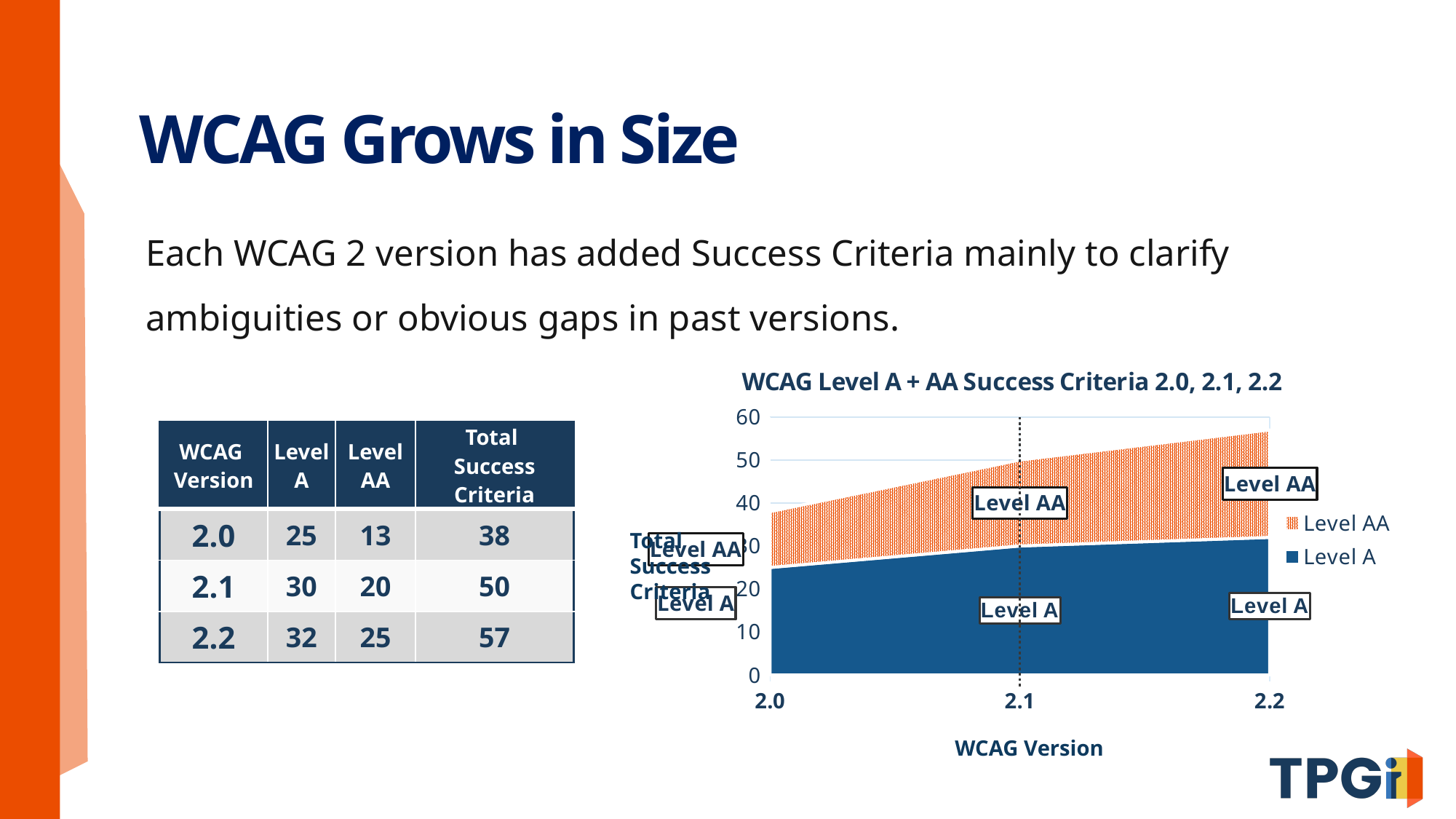
Which WCAG version has the highest total number of success criteria? 2.2 How many series does the chart legend list? 2 How many Level A success criteria does WCAG 2.1 have? 30 How many Level AA success criteria does WCAG 2.2 have? 25 How many WCAG versions are plotted along the x axis of the chart? 3 By how much did the number of Level AA success criteria increase from WCAG 2.0 to WCAG 2.2? 12 What is the label of the chart's x axis? WCAG Version What is the title of the chart? WCAG Level A + AA Success Criteria 2.0, 2.1, 2.2 Is the total number of success criteria for WCAG 2.2 greater or less than 50? greater Do the total success criteria rise or fall from WCAG 2.0 to 2.2 in the chart? Rise What kind of chart is shown on the slide? Area chart What is the total number of Level A + AA success criteria for WCAG 2.0? 38